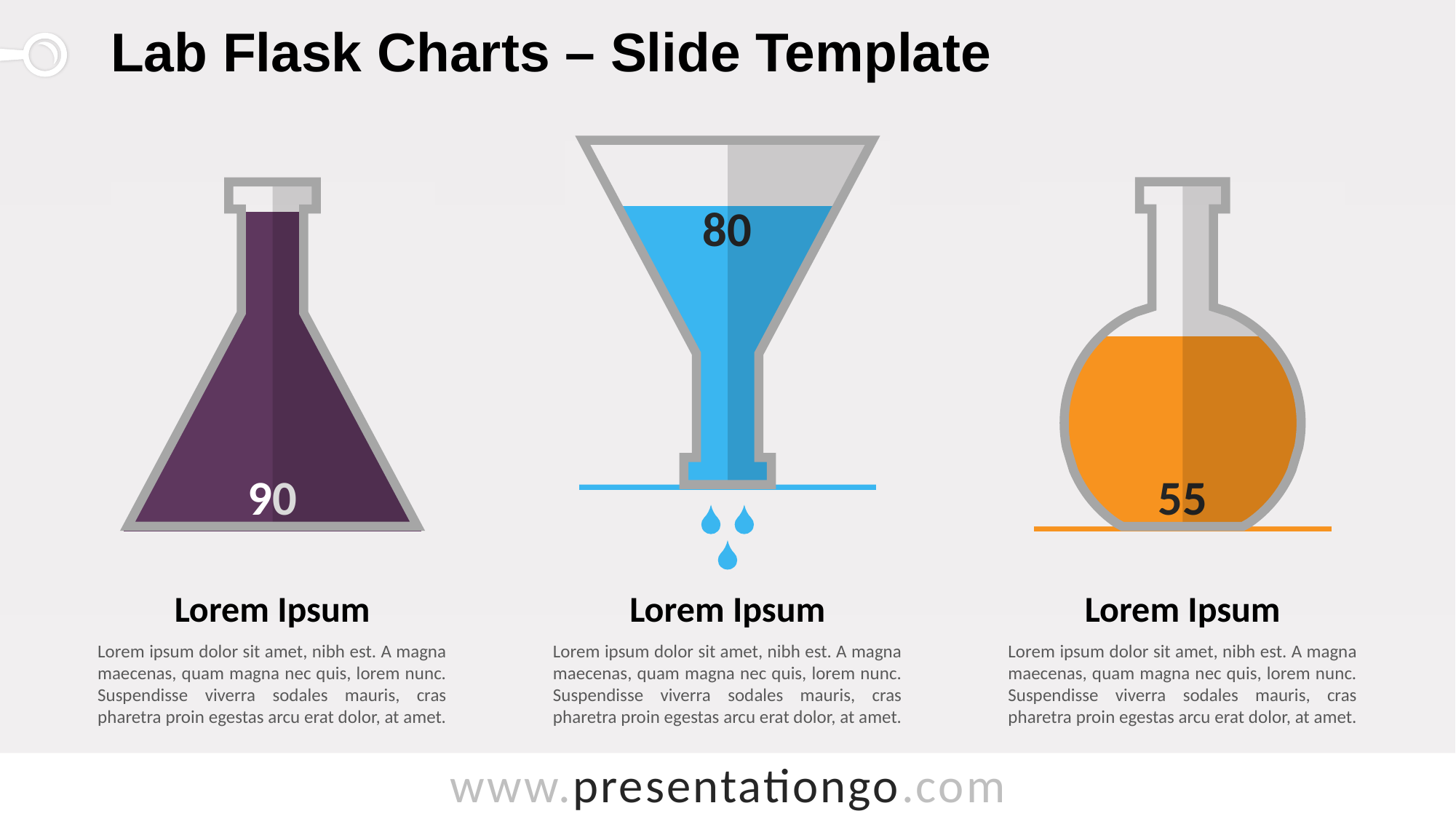
What colour is the liquid in the right round flask chart? Orange Which of the three flask charts shows the lowest value? The right round flask (55) How many flask charts are shown on the slide? 3 Which is larger, the value on the middle funnel or the value on the right round flask? The middle funnel (80) What colour is the liquid in the middle funnel chart? Blue What is the total of the three values shown on the flask charts? 225 What value is shown on the middle funnel chart? 80 What value is shown on the left conical flask chart? 90 What value is shown on the right round flask chart? 55 What is the difference between the value on the left conical flask and the value on the right round flask? 35 Which of the three flask charts shows the highest value? The left conical flask (90) What is the difference between the value on the left conical flask and the value on the middle funnel? 10